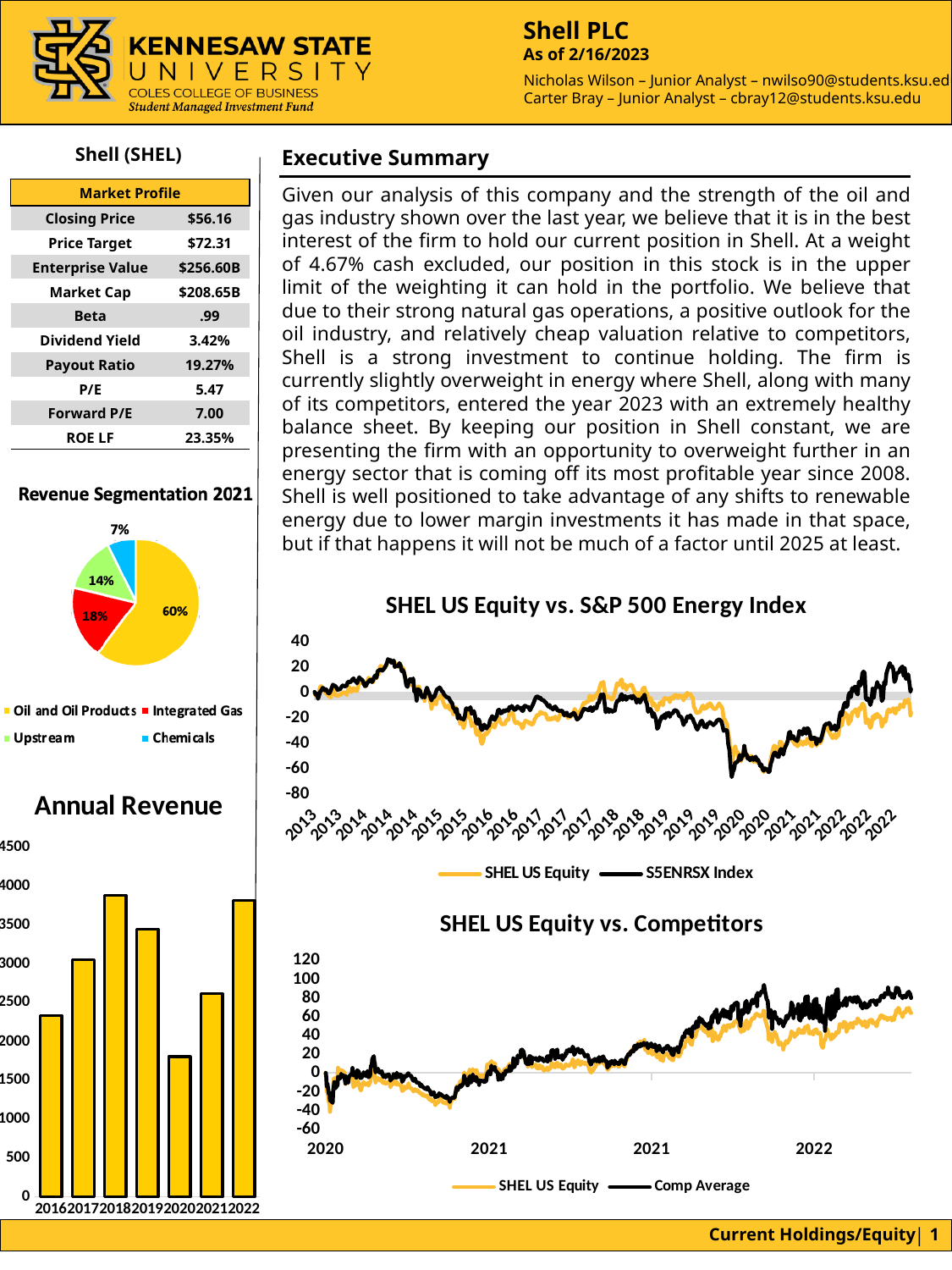
In the Annual Revenue chart, which year has the lowest revenue? 2020 In the Revenue Segmentation 2021 pie chart, what share does Chemicals have? 7% In the Annual Revenue chart, which is larger, the value for 2017 or the value for 2021? 2017 In the Revenue Segmentation 2021 pie chart, which segment has the smallest share? Chemicals In the Revenue Segmentation 2021 pie chart, which segment has the largest share? Oil and Oil Products In the Annual Revenue chart, is the value for 2020 greater or less than 2000? less In the Annual Revenue chart, is the value for 2019 greater or less than 3000? greater In the Revenue Segmentation 2021 pie chart, how many percentage points larger is Integrated Gas than Upstream? 4 In the Revenue Segmentation 2021 pie chart, how many segments are shown? 4 What kind of chart is the Annual Revenue chart? bar chart In the Revenue Segmentation 2021 pie chart, what share does Oil and Oil Products have? 60% How many series does the legend of the SHEL US Equity vs. Competitors chart list? 2